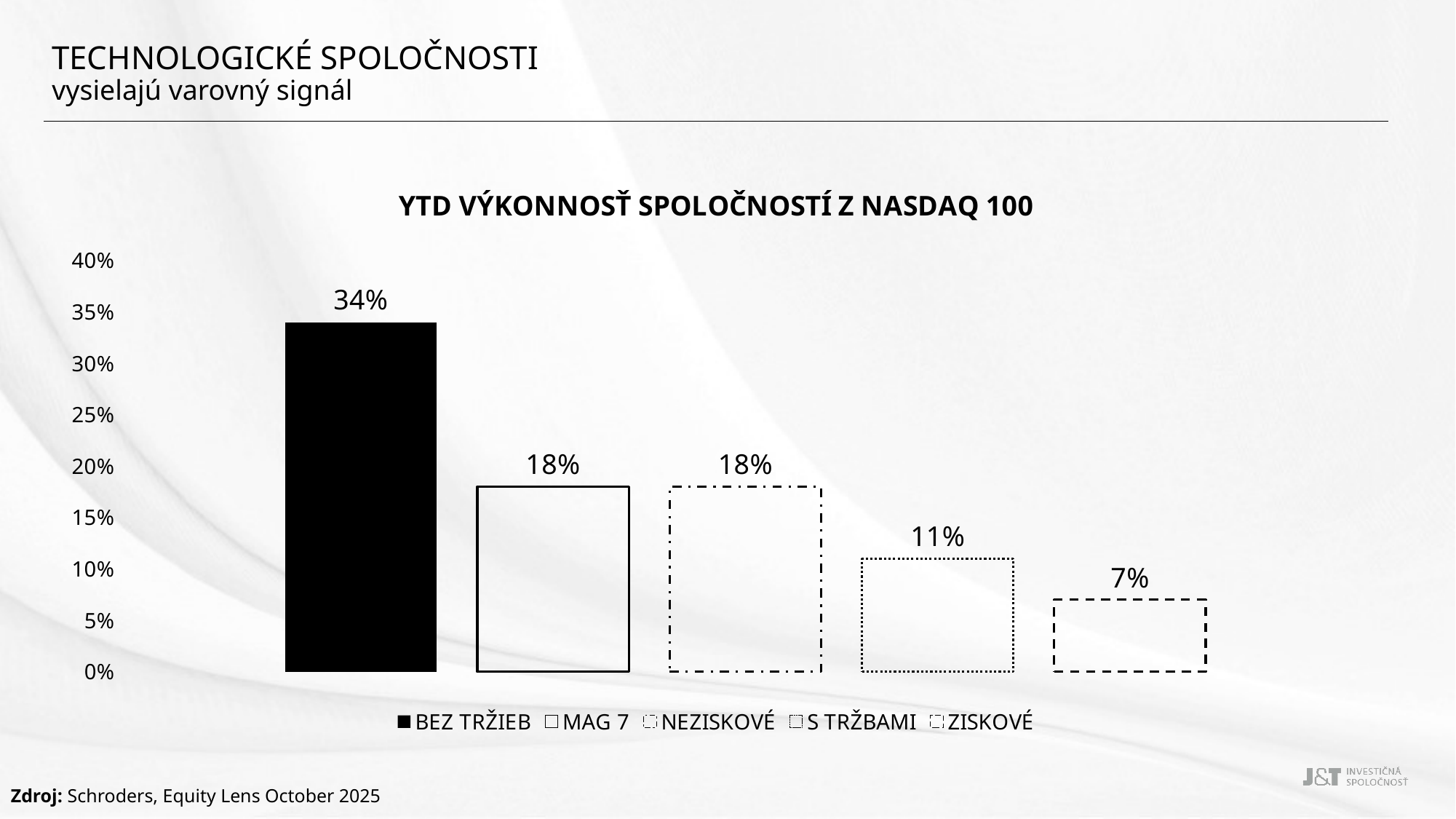
What value is shown for S TRŽBAMI? 11% Which group has the lowest YTD performance? ZISKOVÉ What is the difference between the values for BEZ TRŽIEB and MAG 7? 16% How many entries does the legend list? 5 Which group has the highest YTD performance? BEZ TRŽIEB What is the title of the chart? YTD VÝKONNOSŤ SPOLOČNOSTÍ Z NASDAQ 100 What value is shown for ZISKOVÉ? 7% Which is larger, the value for NEZISKOVÉ or the value for S TRŽBAMI? NEZISKOVÉ How many bars are plotted in the chart? 5 What is the difference between the values for S TRŽBAMI and ZISKOVÉ? 4% What value is shown for MAG 7? 18% What is the YTD performance value shown for BEZ TRŽIEB? 34%